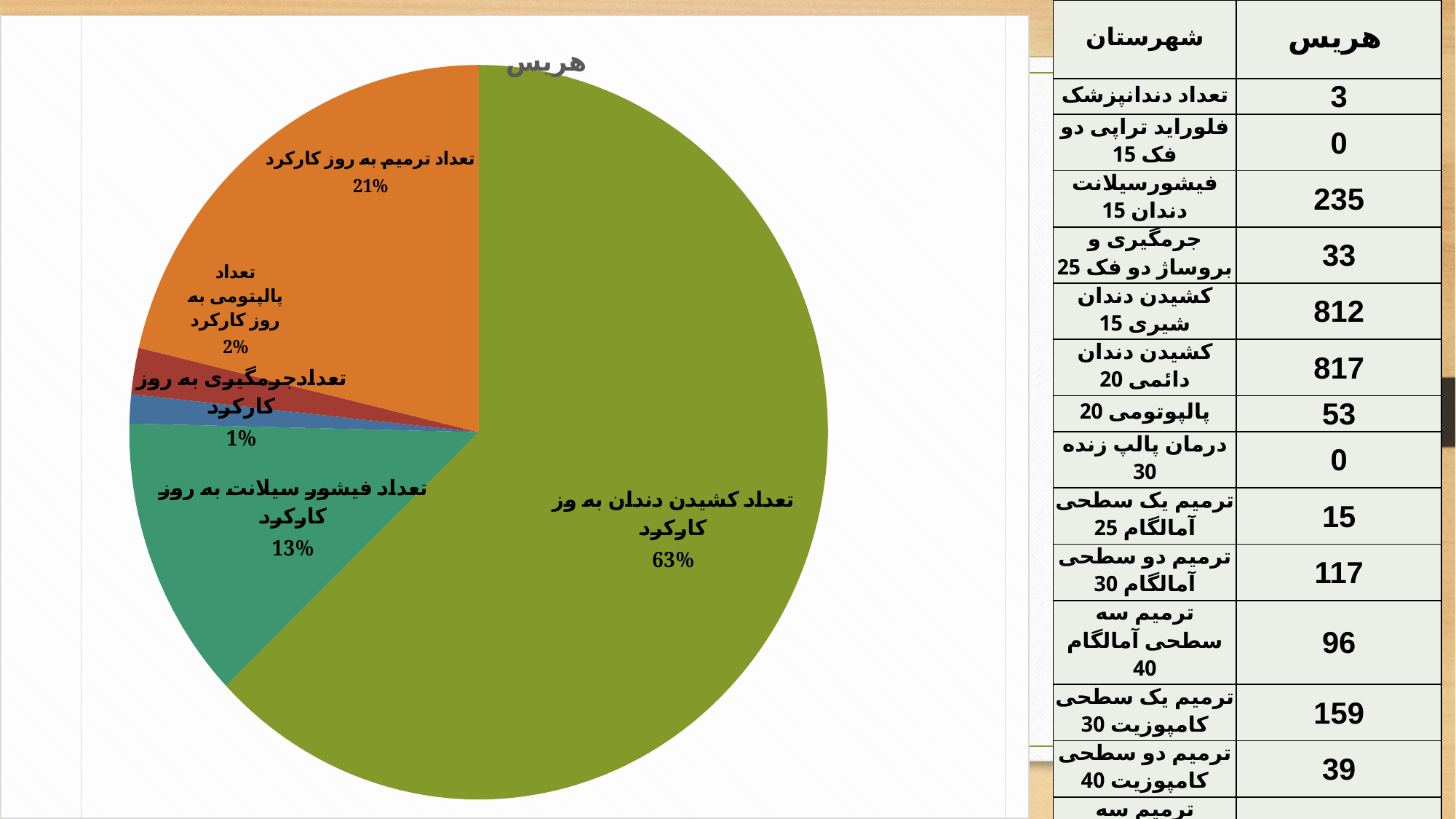
What is the difference in percentage points between the تعداد کشیدن دندان به روز کارکرد slice and the تعداد ترمیم به روز کارکرد slice? 42 Which slice of the pie chart is the largest? تعداد کشیدن دندان به روز کارکرد What share of the pie is labelled تعداد کشیدن دندان به روز کارکرد? 63% What share of the pie is labelled تعداد ترمیم به روز کارکرد? 21% What share of the pie is labelled تعداد فیشور سیلانت به روز کارکرد? 13% Which slice is larger: تعداد فیشور سیلانت به روز کارکرد or تعداد پالپتومی به روز کارکرد? تعداد فیشور سیلانت به روز کارکرد What is the title of the pie chart? هریس How many slices does the pie chart have? 5 Which slice of the pie chart is the smallest? تعداد جرمگیری به روز کارکرد What kind of chart is shown on the slide? pie chart